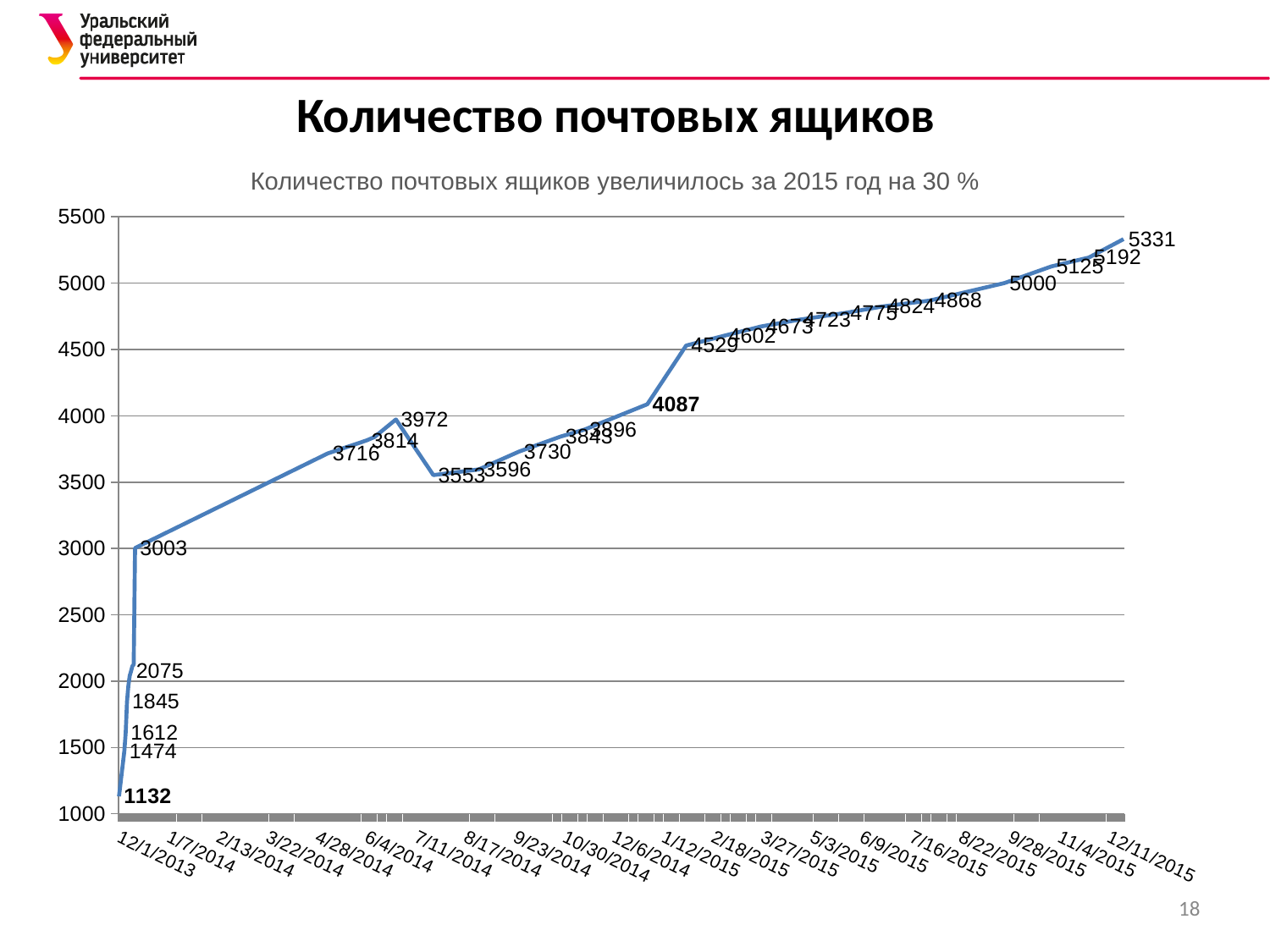
What is the highest value labelled on the chart? 5331 What is the maximum value shown on the vertical axis? 5500 What is the lowest value labelled on the chart? 1132 What is the chart's title? Количество почтовых ящиков увеличилось за 2015 год на 30 % What is the difference between the labelled values 4087 and 4529? 442 What kind of chart is shown on the slide? line chart What is the value of the first data point on the chart? 1132 Overall, do the values rise or fall from left to right along the x axis? rise Is the last data point on the chart greater or less than 5000? greater What is the value of the last data point on the chart? 5331 Which is larger, the value labelled 3972 or the value labelled 3553 that follows it? 3972 What is the difference between the last labelled value (5331) and the first labelled value (1132)? 4199